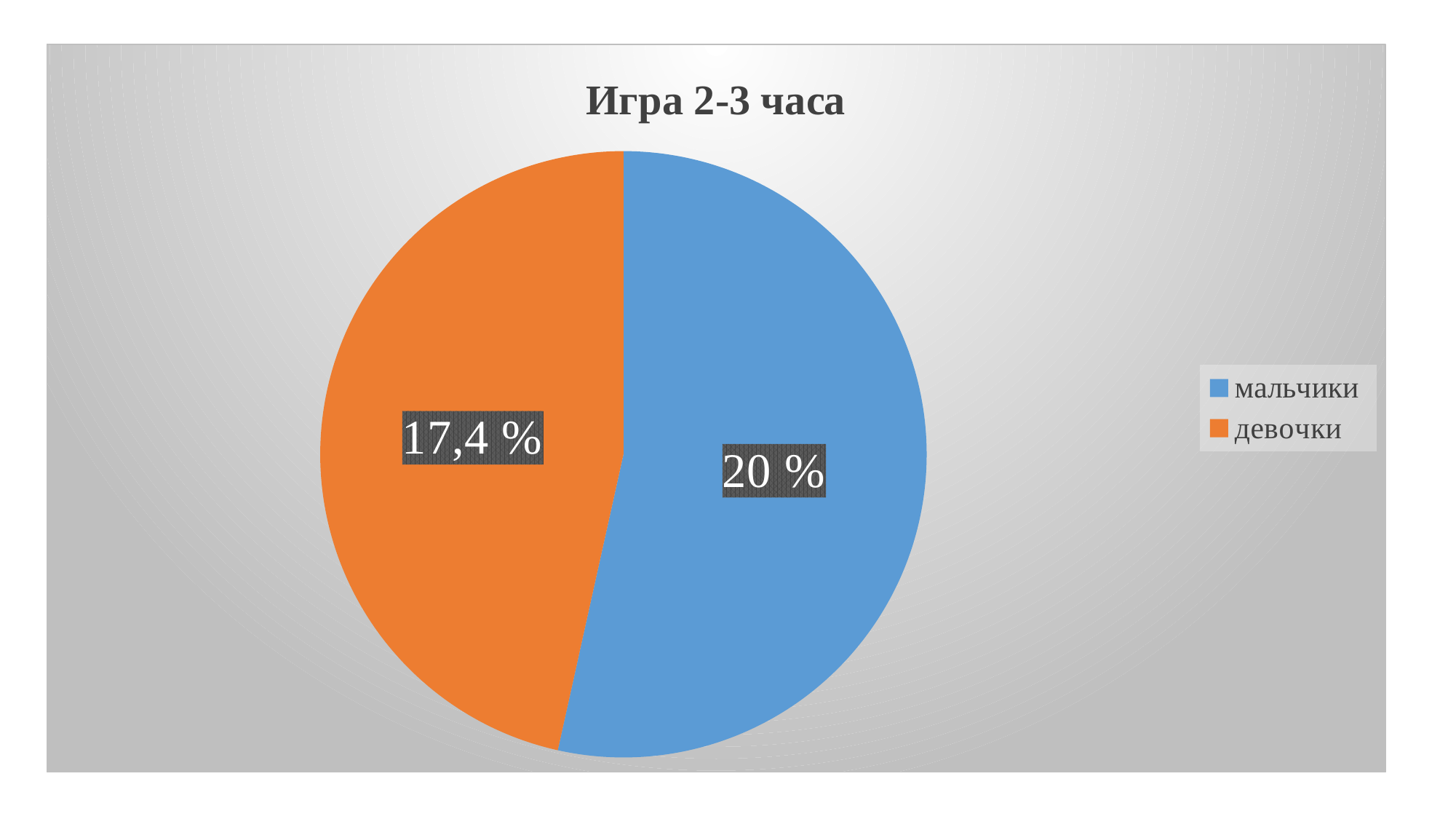
What kind of chart is shown on the slide? pie chart How many entries does the legend list? 2 What is the value shown for мальчики? 20 % Which category has the larger value? мальчики How many slices does the pie chart have? 2 Which colour represents девочки in the chart? orange What is the value shown for девочки? 17,4 % Which category has the smaller value? девочки What is the title of the chart? Игра 2-3 часа Is the value for девочки larger or smaller than the value for мальчики? smaller What is the difference between the values for мальчики and девочки? 2,6 %